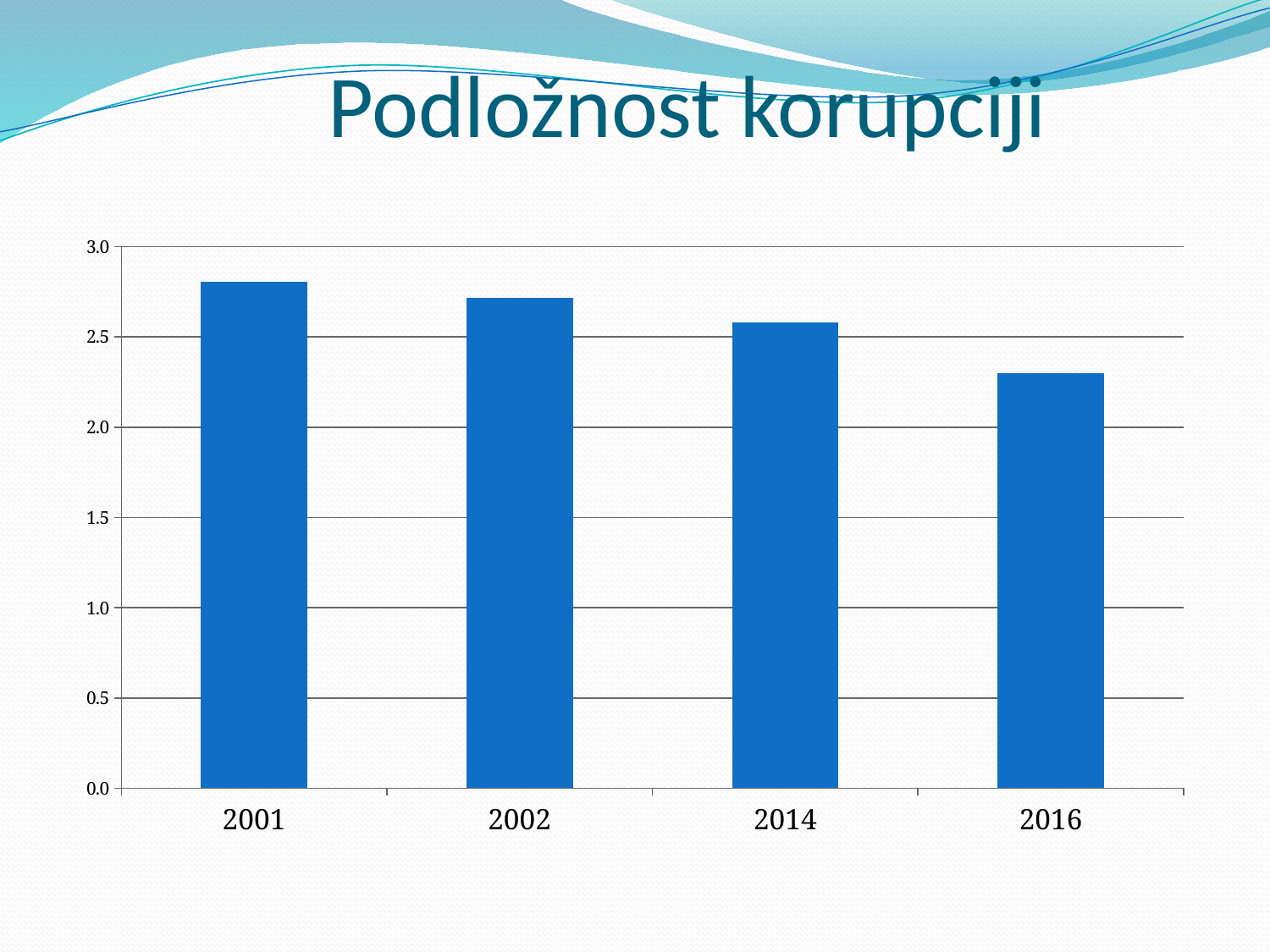
Which year has the highest value in the chart? 2001 Which year has the lowest value in the chart? 2016 How many bars (years) are shown in the chart? 4 Which is larger, the value for 2002 or the value for 2014? 2002 Is the value for 2002 greater or less than 2.5? greater Which is larger, the value for 2001 or the value for 2016? 2001 Do the values rise or fall from 2001 to 2016 along the x axis? fall Is the value for 2001 greater or less than 2.5? greater What kind of chart is shown on the slide? bar chart Is the value for 2016 greater or less than 2.0? greater What is the title of the slide containing the chart? Podložnost korupciji